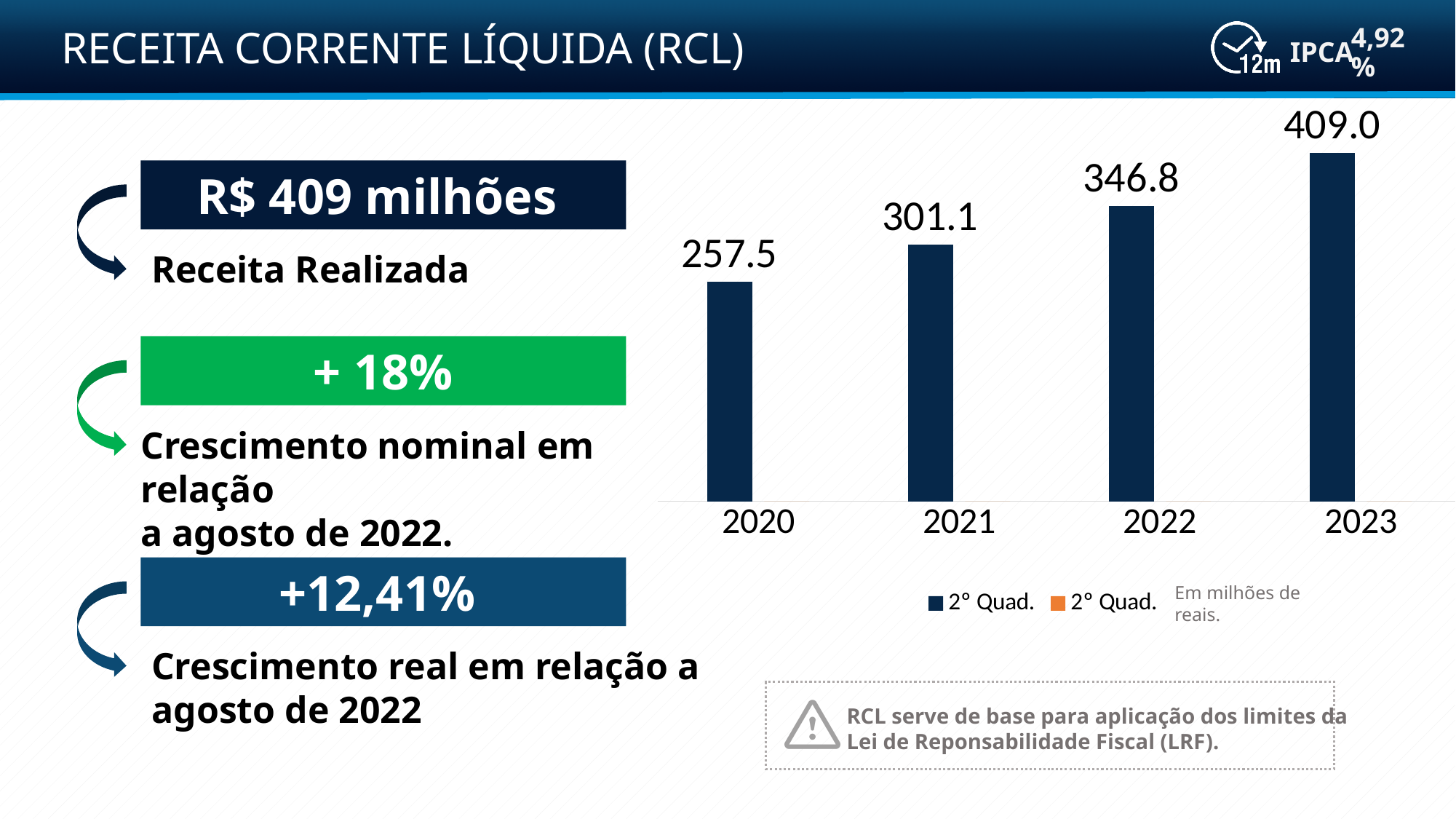
What is the difference between the values for 2021 and 2020? 43.6 Which year has the lowest value? 2020 Which year has the highest value? 2023 What is the value for 2021? 301.1 Do the values rise or fall from 2020 to 2023? rise What is the value for 2020? 257.5 How many years are shown on the x axis? 4 What is the difference between the values for 2023 and 2022? 62.2 What is the value for 2023? 409.0 Which is larger, the value for 2021 or the value for 2022? 2022 What is the value for 2022? 346.8 How many entries does the legend list? 2